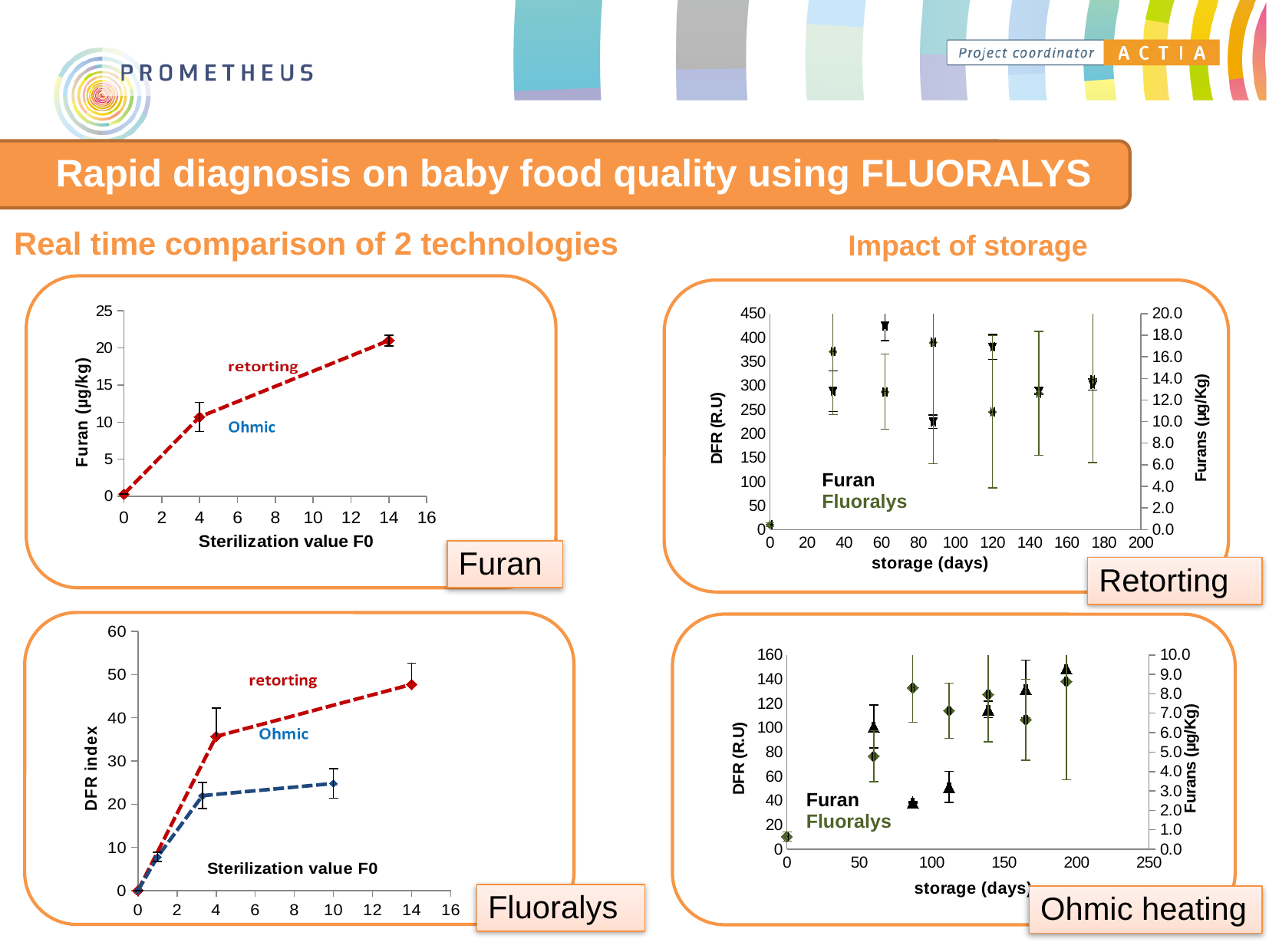
In the top-left Furan chart, is the retorting value at sterilization value F0 = 4 greater or less than 15? less In the top-right Retorting chart, what is the label of the x axis? storage (days) In the bottom-left Fluoralys chart, is the retorting DFR index at sterilization value F0 = 14 greater or less than 40? greater In the bottom-right Ohmic heating chart, is the Fluoralys DFR value at about 85 storage days greater or less than 100? greater In the bottom-left Fluoralys chart, which series has the higher DFR index at sterilization value F0 = 4, retorting or Ohmic? retorting In the top-left Furan chart, does the retorting furan value rise or fall as the sterilization value F0 increases? rise What kind of chart is the top-left Furan chart? line chart In the top-left Furan chart, what is the label of the x axis? Sterilization value F0 In the bottom-left Fluoralys chart, how many series are plotted? 2 In the bottom-left Fluoralys chart, what is the label of the y axis? DFR index